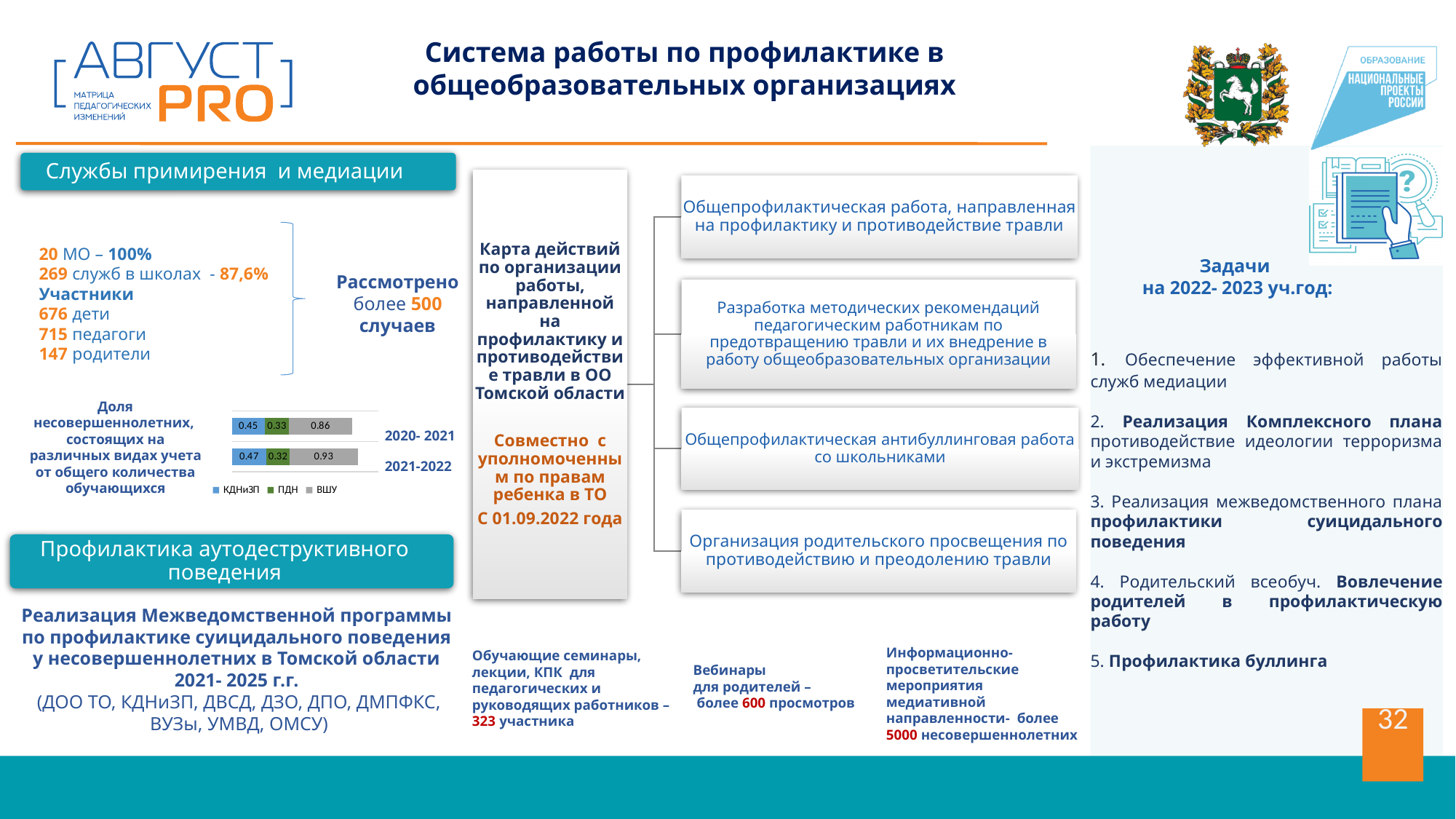
In the stacked bar chart, which series has the lowest value for 2020-2021? ПДН In the stacked bar chart, what is the total of the 2021-2022 bar? 1.72 How many periods (bars) are shown in the stacked bar chart? 2 In the stacked bar chart, which series has the highest value for 2021-2022? ВШУ What kind of chart is shown under the heading 'Доля несовершеннолетних, состоящих на различных видах учета от общего количества обучающихся'? Stacked bar chart In the stacked bar chart, what is the value of ВШУ for 2021-2022? 0.93 How many series does the legend of the stacked bar chart list? 3 In the stacked bar chart, what is the difference between the ВШУ values for 2021-2022 and 2020-2021? 0.07 In the stacked bar chart, what is the value of ВШУ for 2020-2021? 0.86 In the stacked bar chart, what is the value of КДНиЗП for 2020-2021? 0.45 In the stacked bar chart, is the КДНиЗП value larger for 2020-2021 or for 2021-2022? 2021-2022 In the stacked bar chart, what is the value of ПДН for 2021-2022? 0.32